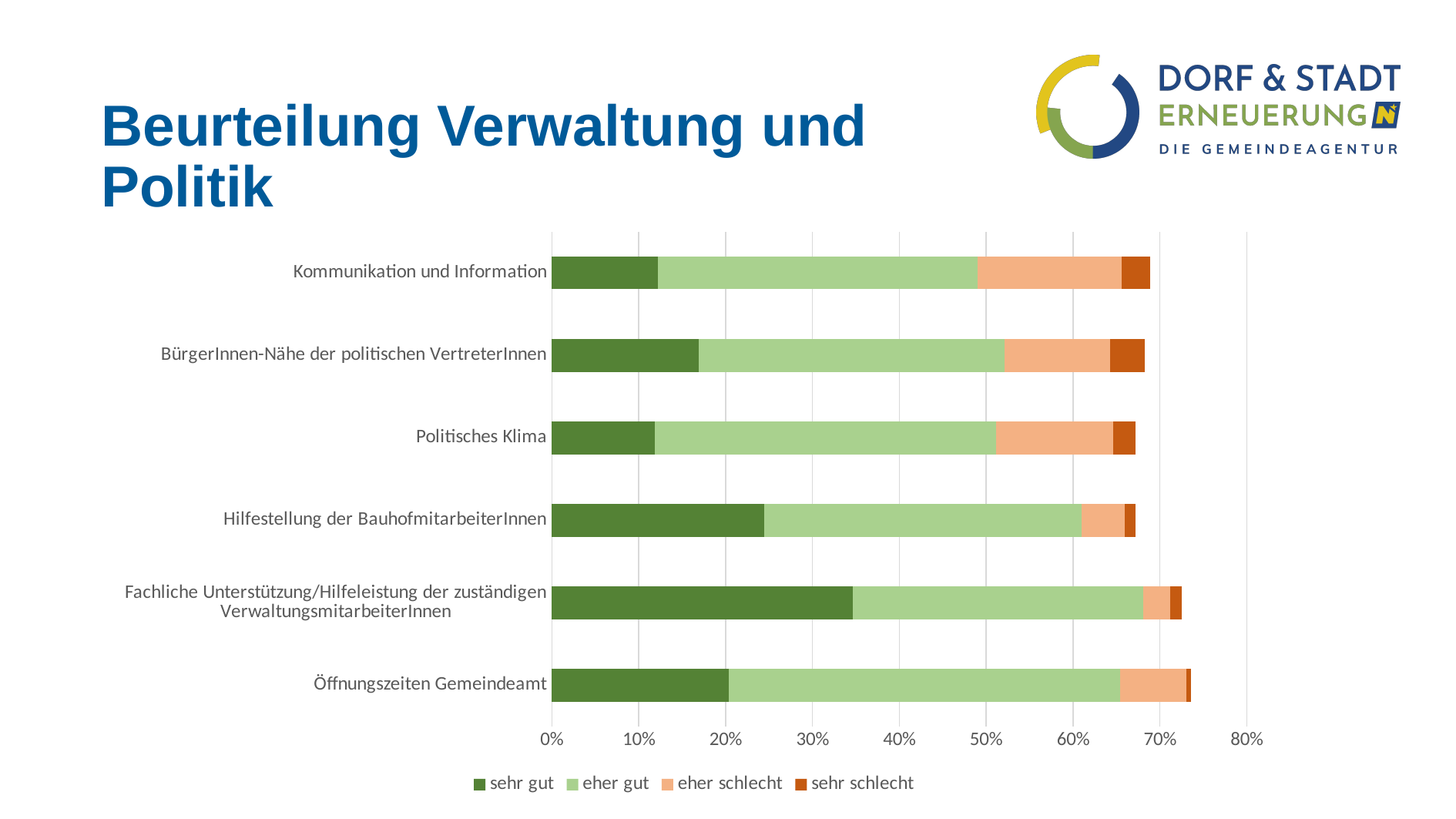
What are the four legend entries of the chart? sehr gut, eher gut, eher schlecht, sehr schlecht What kind of chart is shown on the slide? Stacked bar chart Is the 'sehr gut' value for Kommunikation und Information greater or less than 20%? less Is the total length of the bar for Politisches Klima greater or less than 70%? less How many categories are plotted on the chart? 6 Which has the larger 'sehr gut' segment: Hilfestellung der BauhofmitarbeiterInnen or BürgerInnen-Nähe der politischen VertreterInnen? Hilfestellung der BauhofmitarbeiterInnen Is the total length of the bar for Öffnungszeiten Gemeindeamt greater or less than 70%? greater How many series does the legend list? 4 What is the title of the slide containing the chart? Beurteilung Verwaltung und Politik Which category has the largest 'sehr gut' segment? Fachliche Unterstützung/Hilfeleistung der zuständigen VerwaltungsmitarbeiterInnen